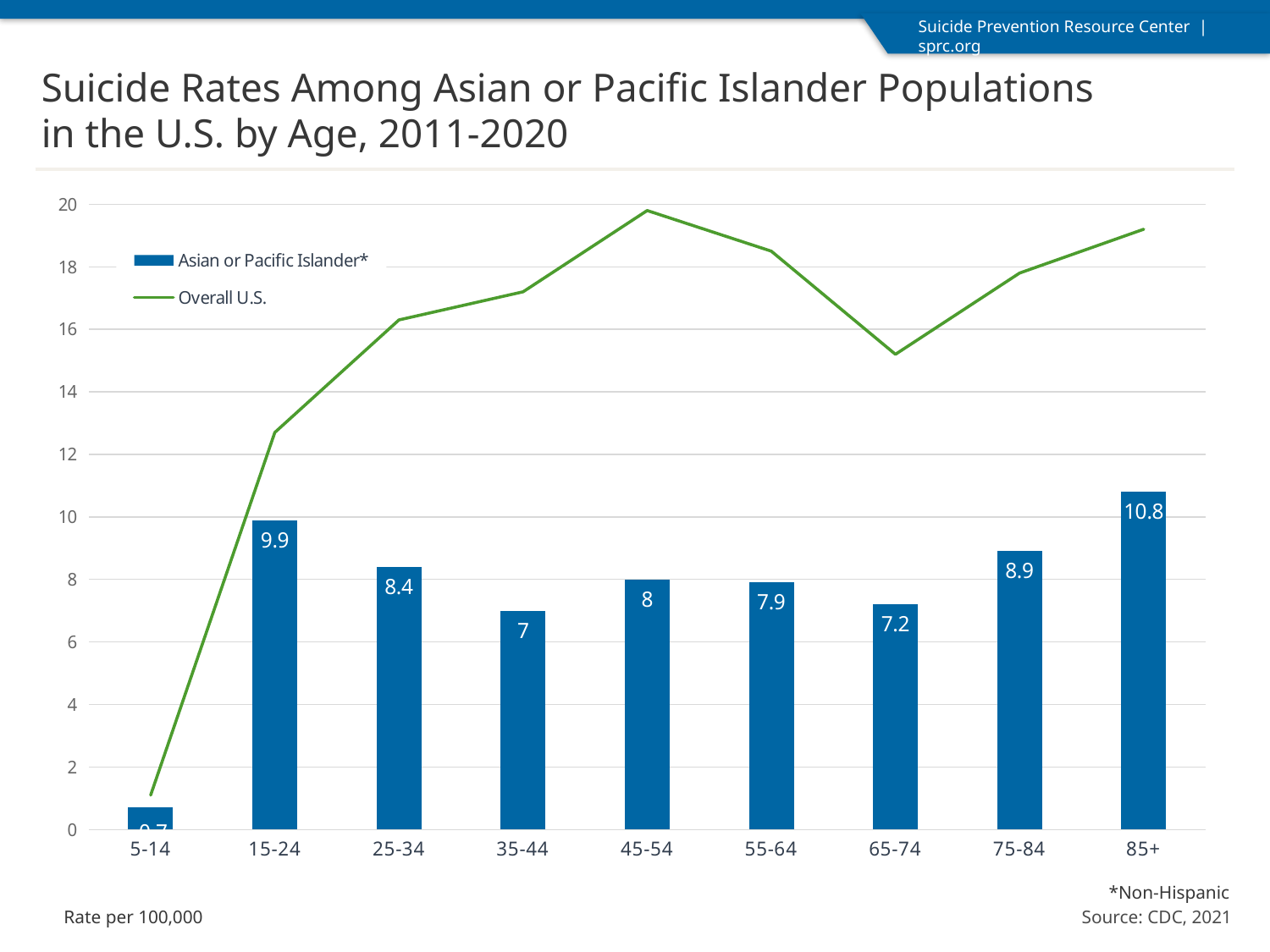
What is the Asian or Pacific Islander suicide rate for the 15-24 age group? 9.9 What is the difference between the Asian or Pacific Islander suicide rates for the 85+ and 15-24 age groups? 0.9 Does the Overall U.S. suicide rate rise or fall from the 5-14 age group to the 45-54 age group? rise Which age group has a higher Asian or Pacific Islander suicide rate, 25-34 or 75-84? 75-84 How many series does the legend list? 2 Is the Overall U.S. suicide rate for the 45-54 age group greater or less than 18? greater What is the Asian or Pacific Islander suicide rate for the 65-74 age group? 7.2 Which age group has the lowest Asian or Pacific Islander suicide rate? 5-14 Is the Overall U.S. suicide rate for the 65-74 age group greater or less than 16? less How many age groups are shown on the x axis? 9 What is the Asian or Pacific Islander suicide rate for the 85+ age group? 10.8 Which age group has the highest Asian or Pacific Islander suicide rate? 85+